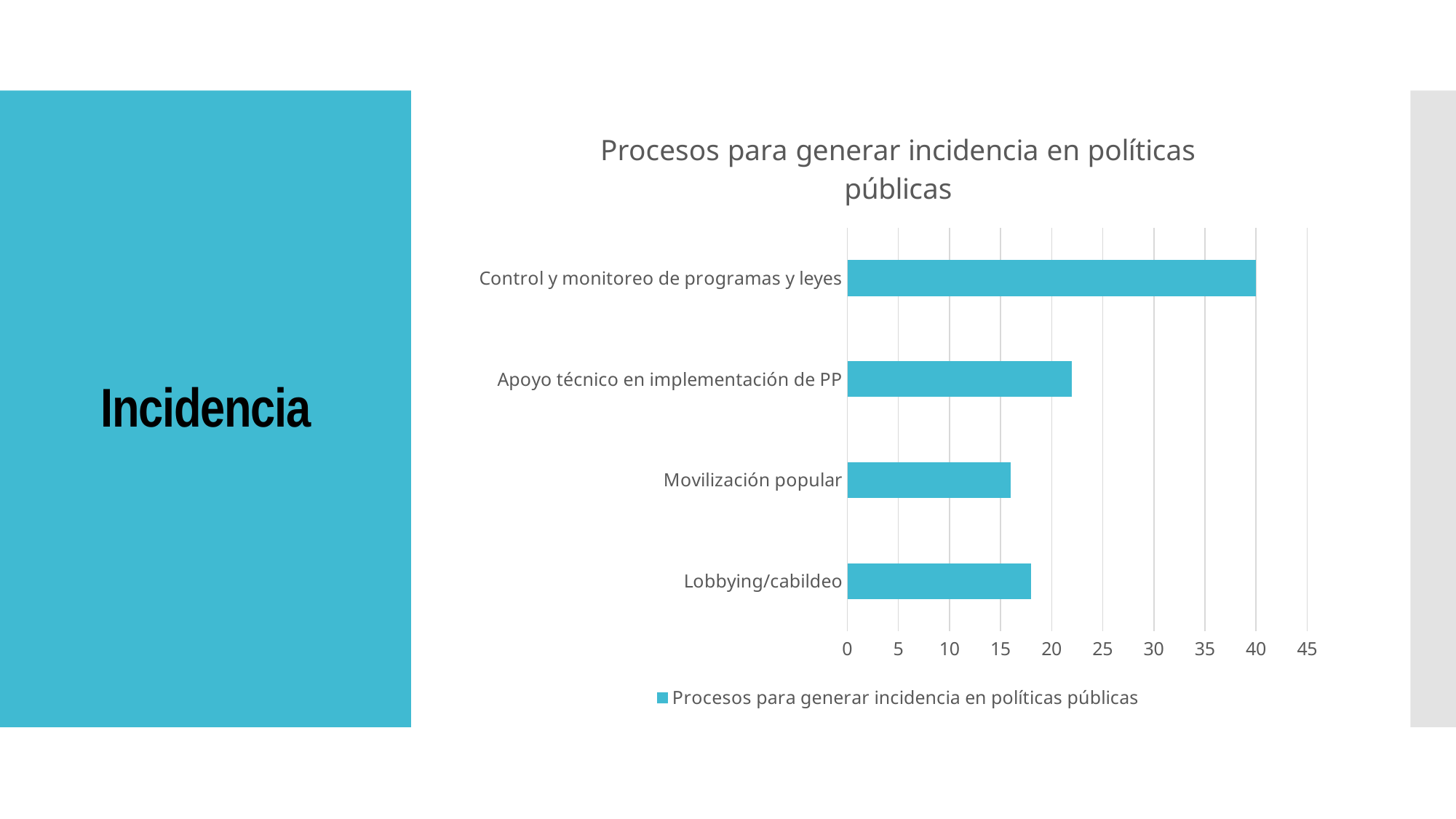
How many categories are plotted in the chart? 4 What is the maximum value shown on the horizontal axis? 45 Which is larger, the value for Apoyo técnico en implementación de PP or the value for Lobbying/cabildeo? Apoyo técnico en implementación de PP How many series does the legend list? 1 Is the value for Apoyo técnico en implementación de PP greater or less than 20? greater Is the value for Movilización popular greater or less than 20? less Which category has the lowest value? Movilización popular Is the value for Lobbying/cabildeo greater or less than 15? greater What type of chart is shown on the slide? bar chart Which category has the highest value? Control y monitoreo de programas y leyes What is the title of the chart? Procesos para generar incidencia en políticas públicas What is the value for Control y monitoreo de programas y leyes? 40